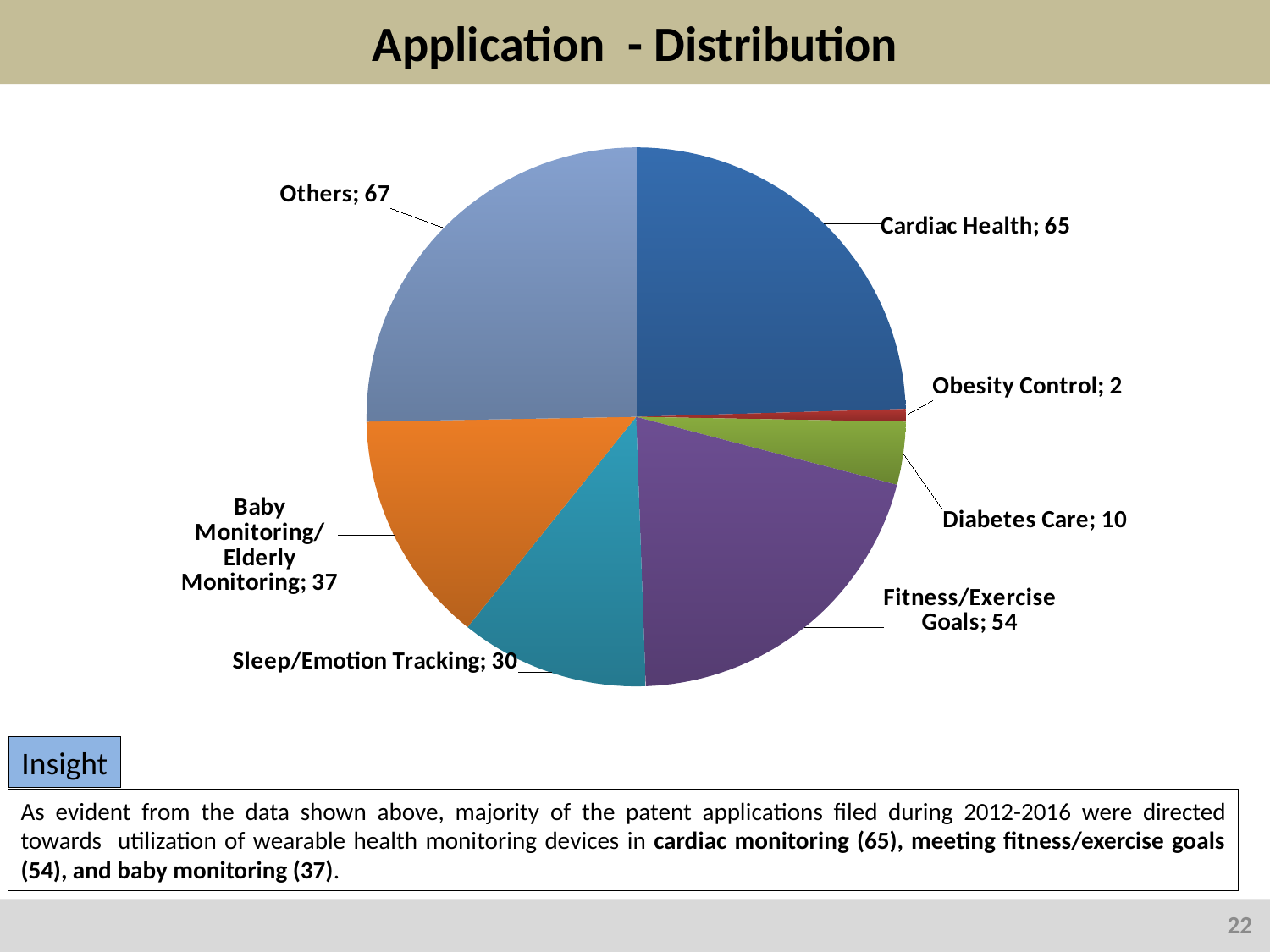
What is the title of the slide containing the pie chart? Application - Distribution What is the total of all the values in the pie chart? 265 What is the value for Sleep/Emotion Tracking? 30 Which category has the largest value? Others Which category has the smallest value? Obesity Control How many categories does the pie chart show? 7 Which is larger, Diabetes Care or Sleep/Emotion Tracking? Sleep/Emotion Tracking What is the value for Fitness/Exercise Goals? 54 What is the value for Cardiac Health? 65 What is the difference between the values for Cardiac Health and Fitness/Exercise Goals? 11 What is the value for Baby Monitoring/Elderly Monitoring? 37 What type of chart is shown on the slide? Pie chart